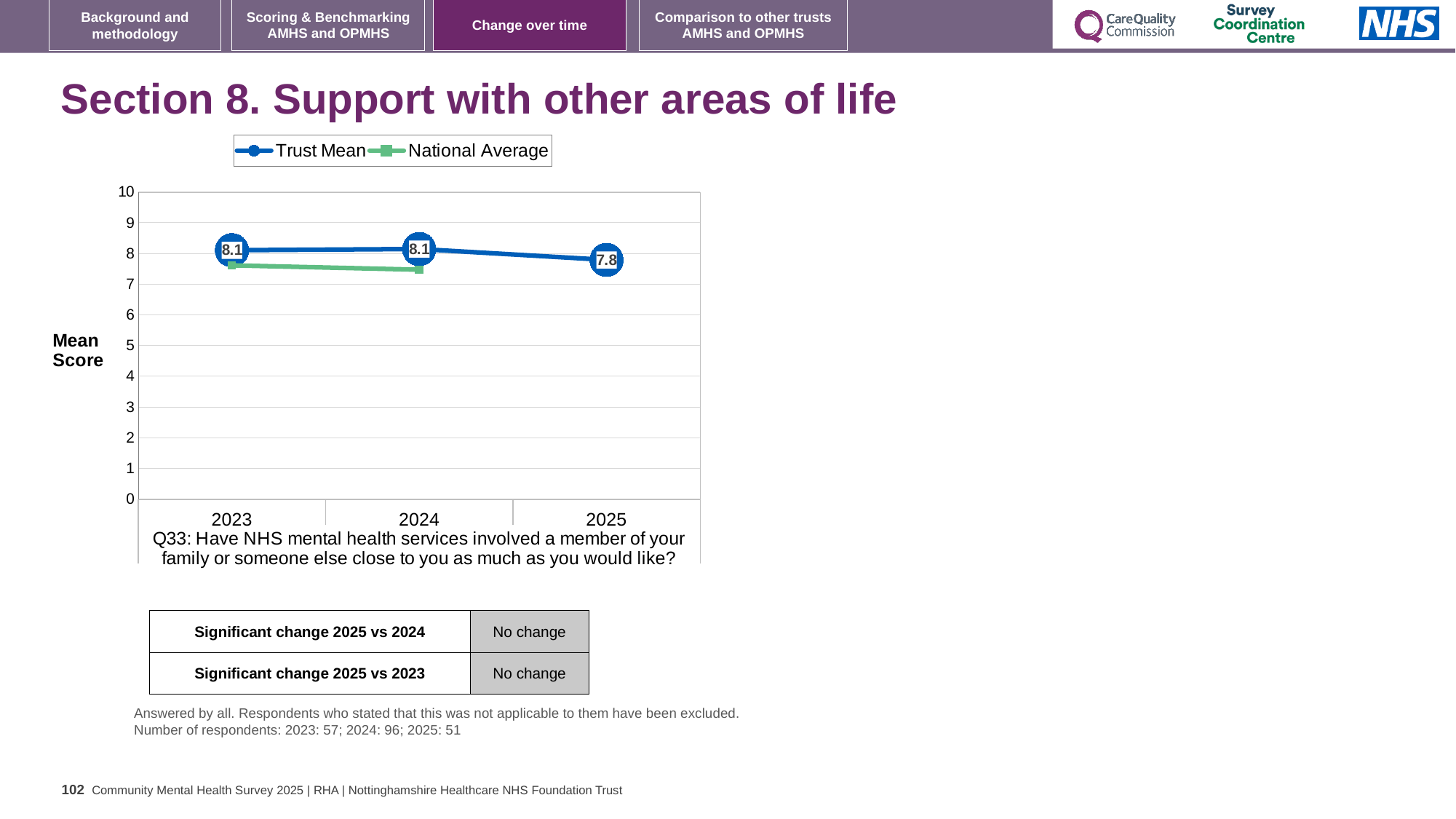
How many series does the chart legend list? 2 What is the Trust Mean value for 2023? 8.1 What is the Trust Mean value for 2025? 7.8 In which year is the Trust Mean lowest? 2025 Does the Trust Mean rise or fall from 2024 to 2025? Fall Which is larger, the Trust Mean in 2024 or the Trust Mean in 2025? 2024 What kind of chart is shown on the slide? Line chart Is the National Average value for 2024 greater or less than 8? less How many years are shown on the x axis of the chart? 3 What is the Trust Mean value for 2024? 8.1 What is the difference between the Trust Mean in 2023 and in 2025? 0.3 Is the National Average value for 2023 greater or less than 7? greater